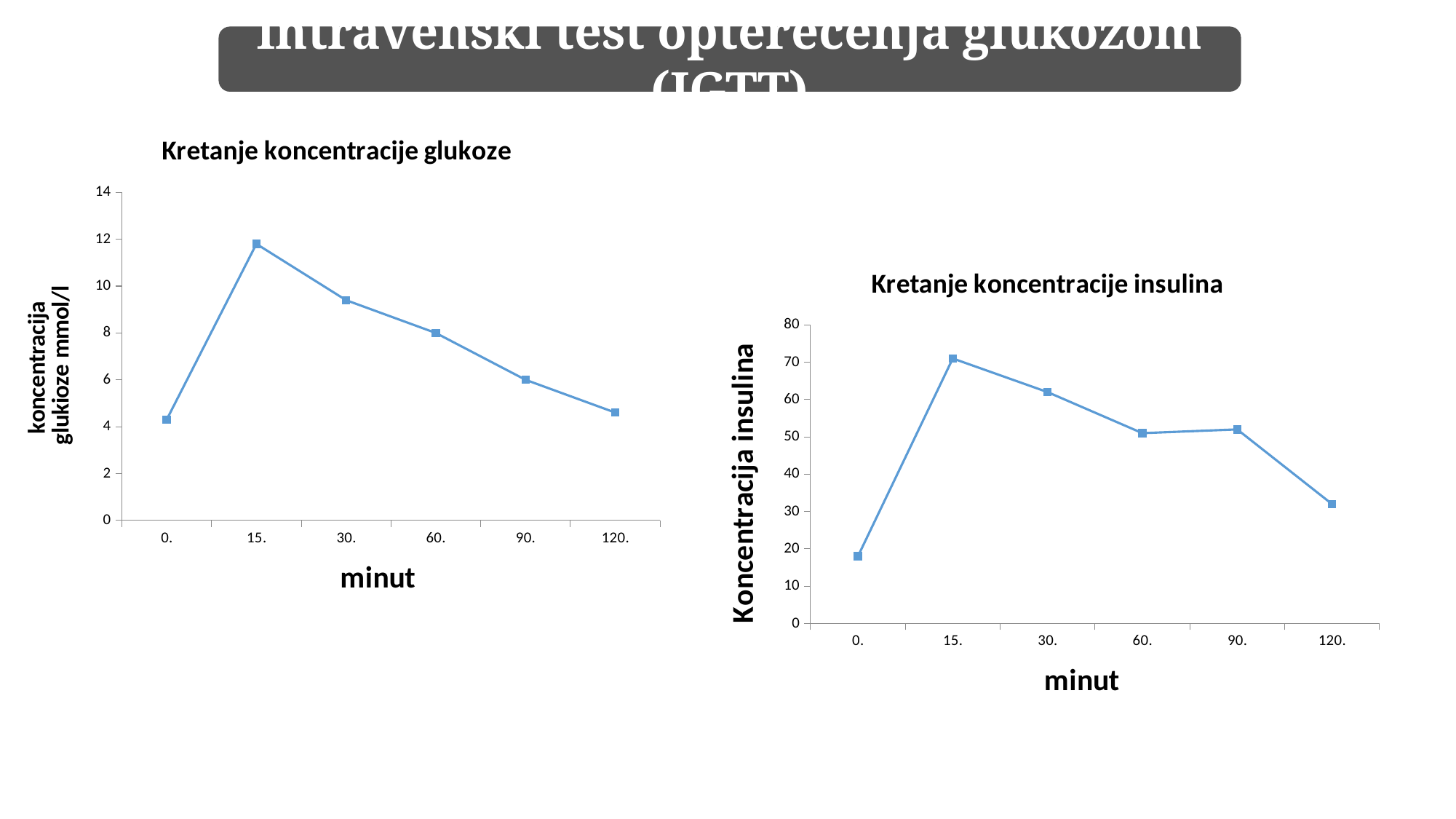
In the 'Kretanje koncentracije glukoze' chart, how many time points are plotted? 6 In the 'Kretanje koncentracije insulina' chart, at which minute is the insulin concentration highest? 15. What is the x-axis title of the 'Kretanje koncentracije insulina' chart? minut In the 'Kretanje koncentracije insulina' chart, is the value at 120 minutes greater or less than 40? less In the 'Kretanje koncentracije glukoze' chart, at which minute is the glucose concentration highest? 15. In the 'Kretanje koncentracije glukoze' chart, what is the glucose concentration at 60 minutes? 8 In the 'Kretanje koncentracije insulina' chart, at which minute is the insulin concentration lowest? 0. In the 'Kretanje koncentracije glukoze' chart, does the glucose concentration rise or fall from 15 minutes to 120 minutes? fall In the 'Kretanje koncentracije insulina' chart, which is larger: the value at 30 minutes or at 120 minutes? 30. What kind of chart is the 'Kretanje koncentracije glukoze' chart? line chart In the 'Kretanje koncentracije glukoze' chart, what is the glucose concentration at 90 minutes? 6 In the 'Kretanje koncentracije glukoze' chart, is the value at 15 minutes greater or less than 10? greater